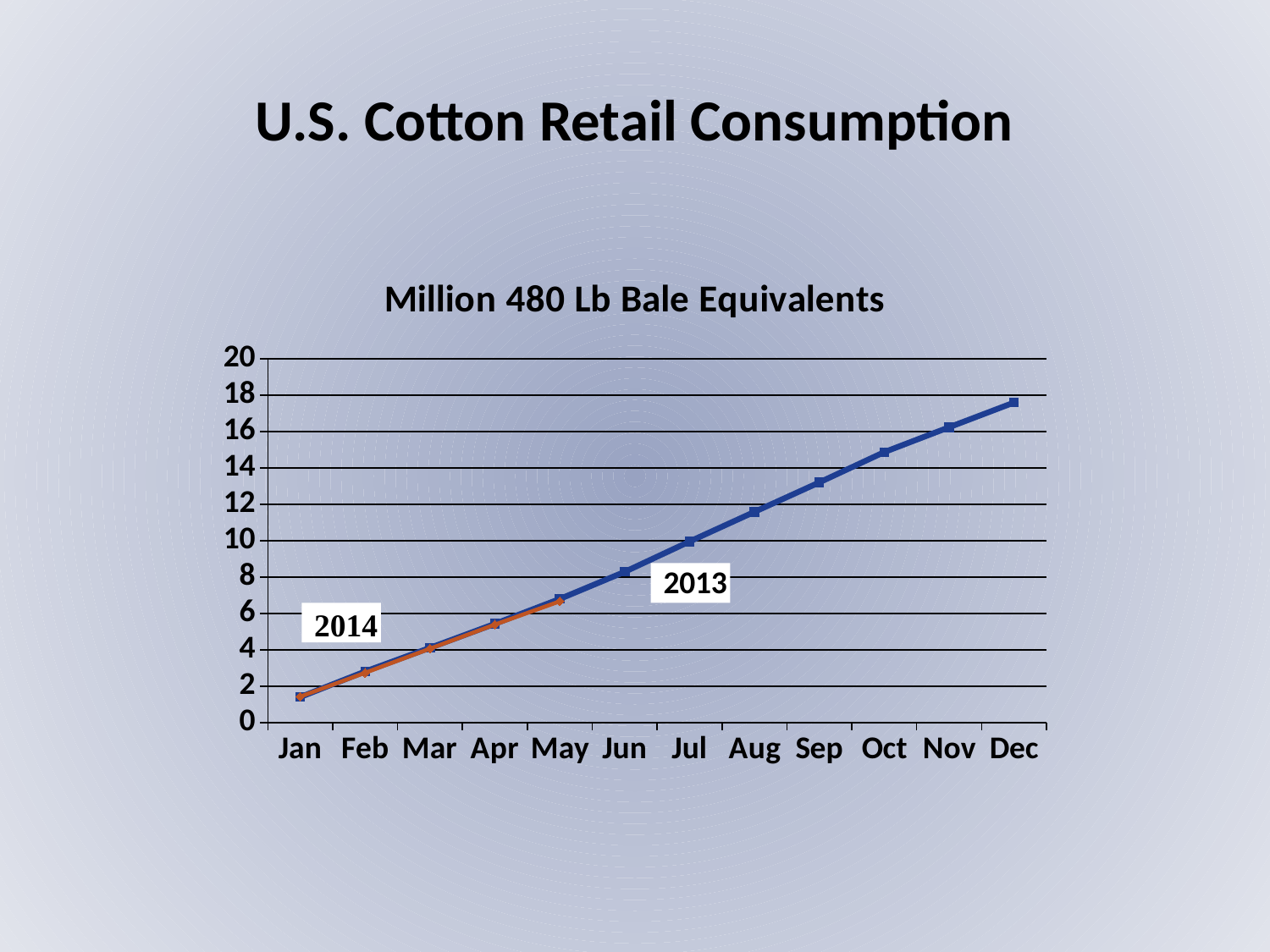
Is the 2013 value for Jan greater or less than 2? less Which is larger for the 2013 series, the value for Sep or the value for Jun? Sep Is the 2013 value for Dec greater or less than 16? greater What kind of chart is shown on the slide? line chart Which years are the two series labelled on the chart? 2013 and 2014 How many data series are plotted on the chart? 2 What unit is given in the chart's subtitle? Million 480 Lb Bale Equivalents In which month is the 2013 series at its lowest value? Jan Do the values for the 2013 series rise or fall from Jan to Dec? rise How many months are shown on the x axis of the chart? 12 Is the 2014 value for May greater or less than 6? greater In which month does the 2013 series reach its highest value? Dec